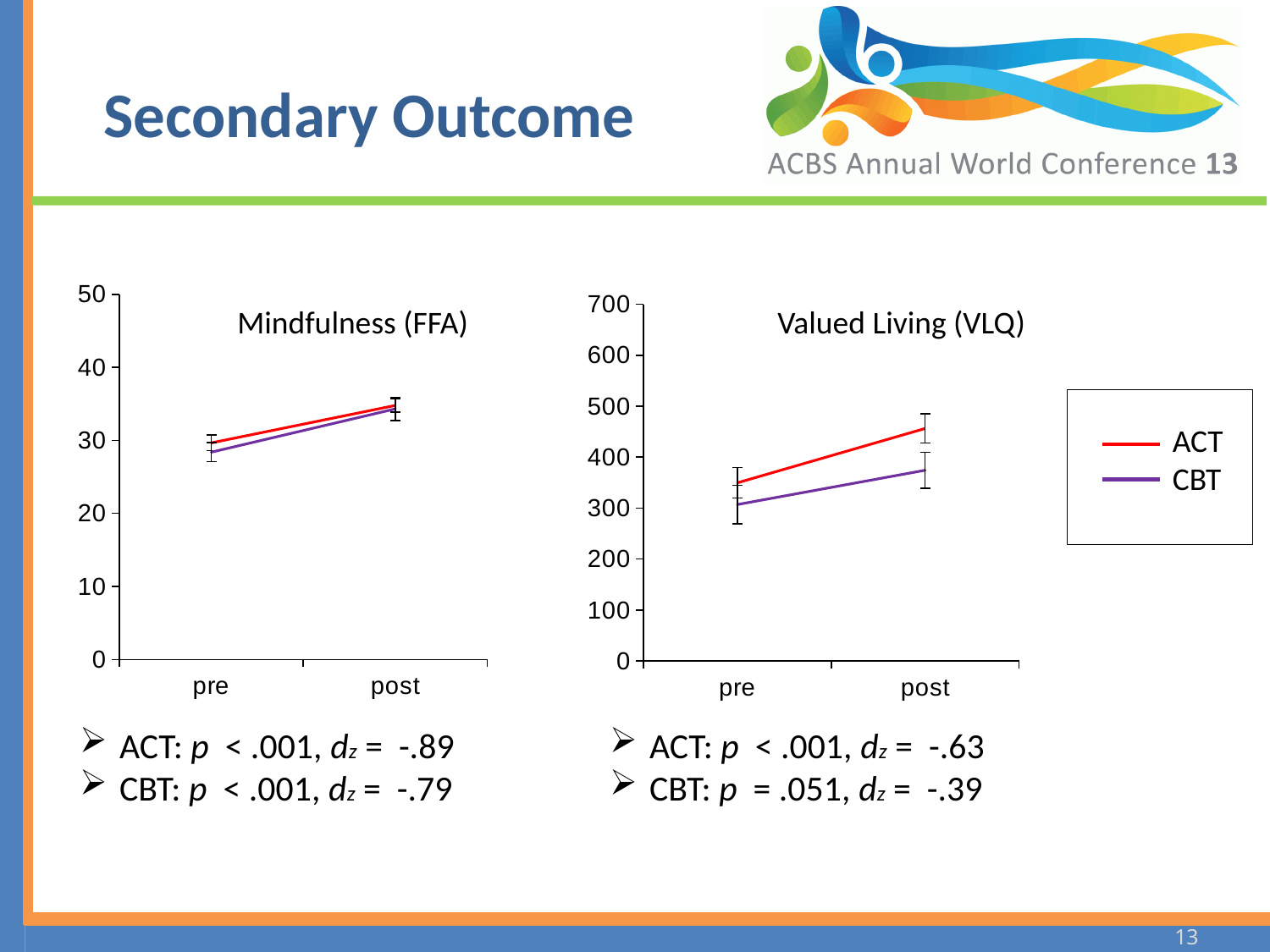
In the Valued Living (VLQ) chart, is the CBT value at pre greater or less than 400? less In the Valued Living (VLQ) chart, which series has the higher value at post, ACT or CBT? ACT In the Mindfulness (FFA) chart, is the ACT value at post greater or less than 30? greater In the Mindfulness (FFA) chart, do the ACT values rise or fall from pre to post? rise Which colour represents the CBT series in the legend? purple How many series does the legend list? 2 In the Valued Living (VLQ) chart, is the CBT value at post greater or less than 500? less In the Valued Living (VLQ) chart, do the CBT values rise or fall from pre to post? rise What kind of chart is the Mindfulness (FFA) chart? line chart In the Valued Living (VLQ) chart, how many time points are shown on the x axis? 2